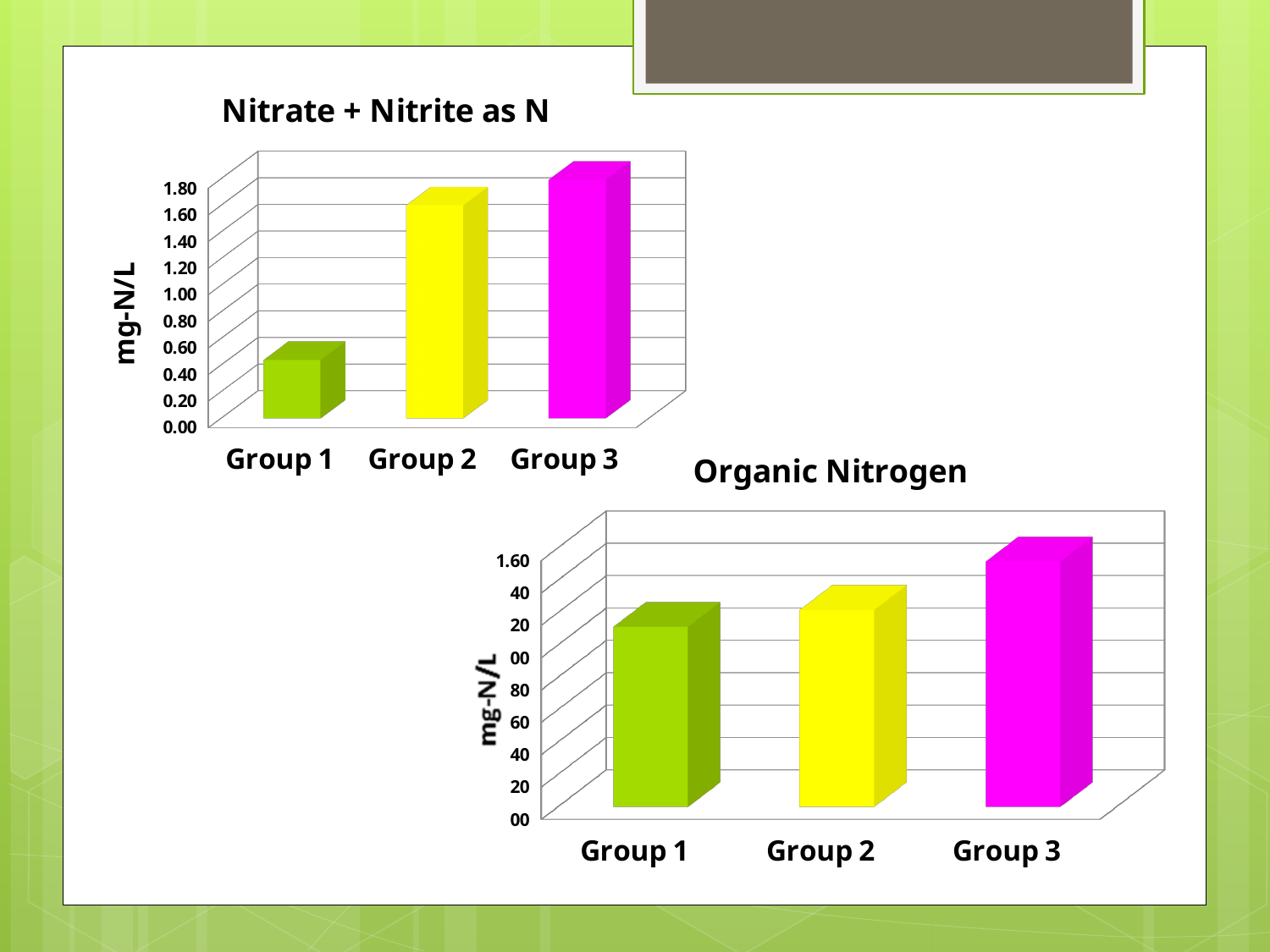
How many groups are shown in the 'Nitrate + Nitrite as N' chart? 3 In the 'Nitrate + Nitrite as N' chart, is the value for Group 2 greater or less than 1.00? greater In the 'Nitrate + Nitrite as N' chart, which group has the highest value? Group 3 What colour is the Group 3 bar in the 'Organic Nitrogen' chart? magenta What kind of chart is the 'Organic Nitrogen' chart? bar chart In the 'Nitrate + Nitrite as N' chart, is the value for Group 1 greater or less than 1.00? less In the 'Organic Nitrogen' chart, do the values rise or fall from Group 1 to Group 3? rise In the 'Organic Nitrogen' chart, which group has the highest value? Group 3 What is the y-axis label of the 'Nitrate + Nitrite as N' chart? mg-N/L In the 'Nitrate + Nitrite as N' chart, which group has the lowest value? Group 1 In the 'Nitrate + Nitrite as N' chart, which is larger, the value for Group 1 or the value for Group 2? Group 2 In the 'Organic Nitrogen' chart, which group has the lowest value? Group 1